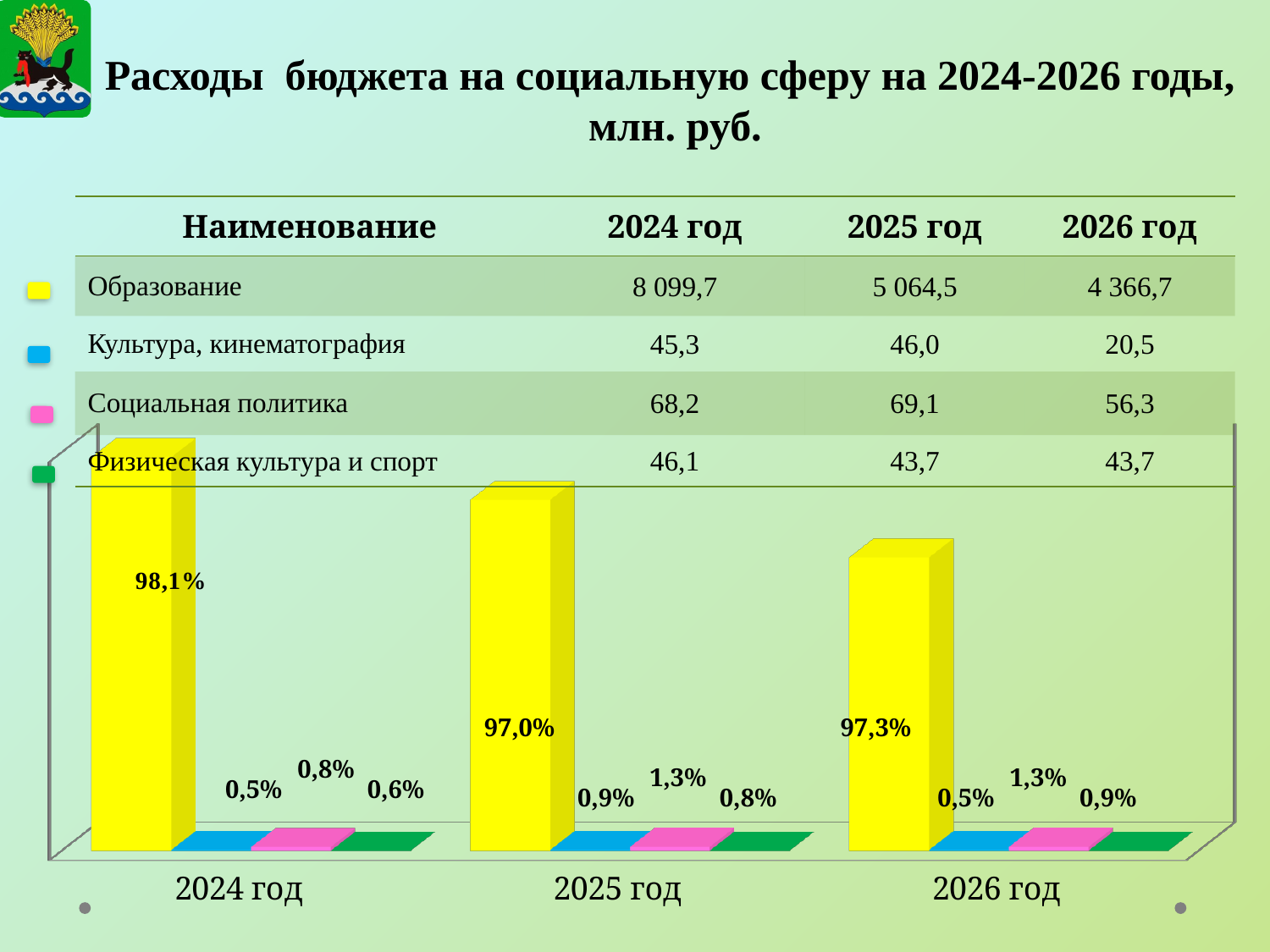
What share does the yellow bar (Образование) show for 2025 год? 97,0% In which year is the share for Образование (yellow bar) the highest? 2024 год How many series (colours) does the chart show? 4 What kind of chart is shown on the slide? bar chart In which year is the share for Образование (yellow bar) the lowest? 2025 год What share does the green bar (Физическая культура и спорт) show for 2026 год? 0,9% What is the difference between the Образование share in 2024 год (98,1%) and in 2025 год (97,0%)? 1,1% What share does the pink bar (Социальная политика) show for 2025 год? 1,3% How many year groups are shown on the x axis of the chart? 3 What share does the yellow bar (Образование) show for 2026 год? 97,3% What share does the yellow bar (Образование) show for 2024 год? 98,1% Which is larger in 2024 год: the blue bar (Культура, кинематография) at 0,5% or the pink bar (Социальная политика) at 0,8%? Социальная политика (0,8%)